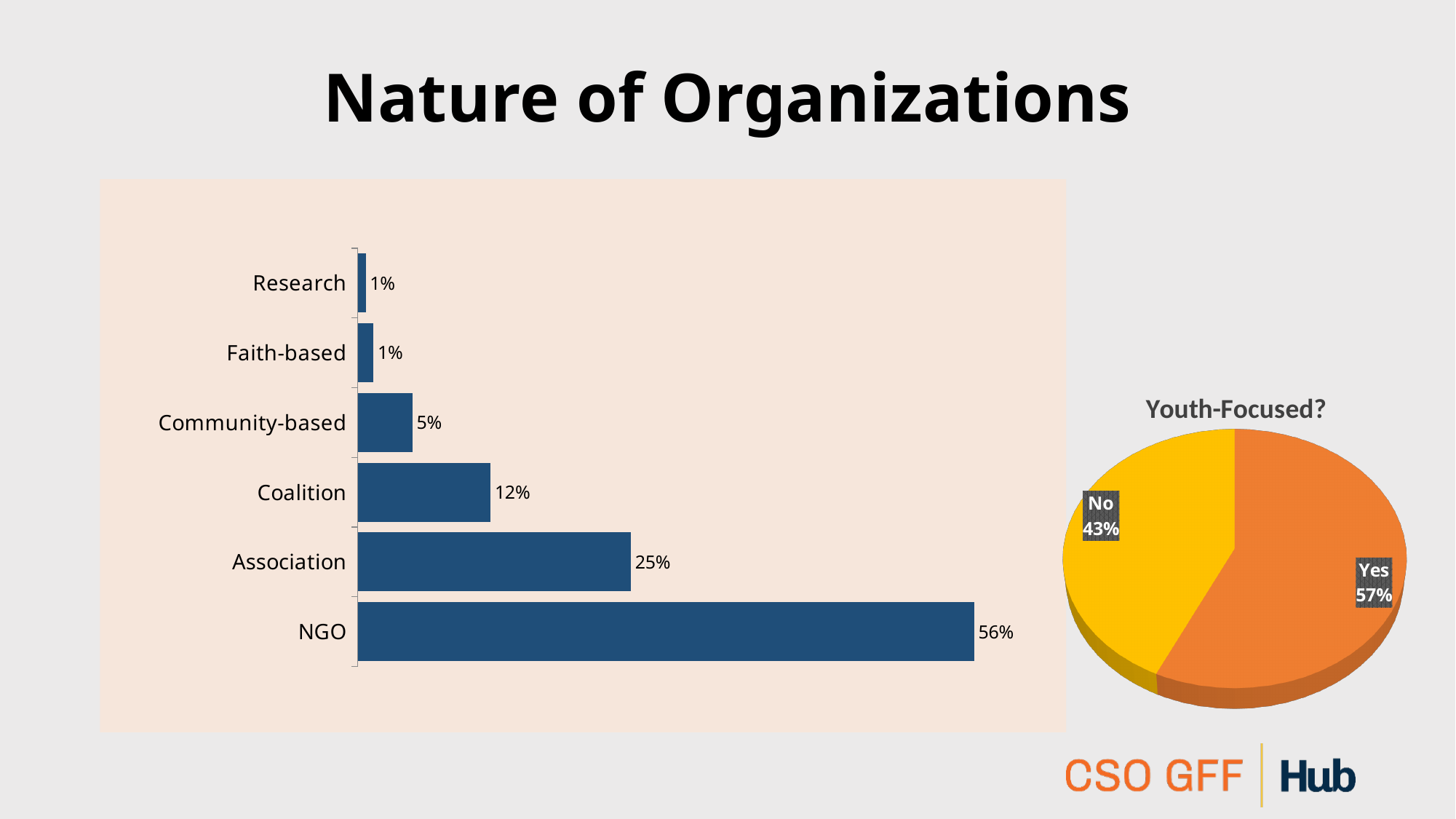
How many categories does the bar chart on the left show? 6 In the bar chart on the left, what is the value for Coalition? 12% In the bar chart on the left, what is the difference between the values for NGO and Association? 31% In the bar chart on the left, which is larger, the value for Coalition or the value for Community-based? Coalition In the 'Youth-Focused?' pie chart, what is the difference between the Yes and No shares? 14% In the bar chart on the left, which category has the highest value? NGO In the bar chart on the left, what is the value for NGO? 56% In the 'Youth-Focused?' pie chart, what share is labelled Yes? 57% What kind of chart is the 'Youth-Focused?' chart on the right? Pie chart In the 'Youth-Focused?' pie chart, what is the value for No? 43% In the bar chart on the left, what is the value for Community-based? 5% What kind of chart is the chart on the left of the slide? Bar chart